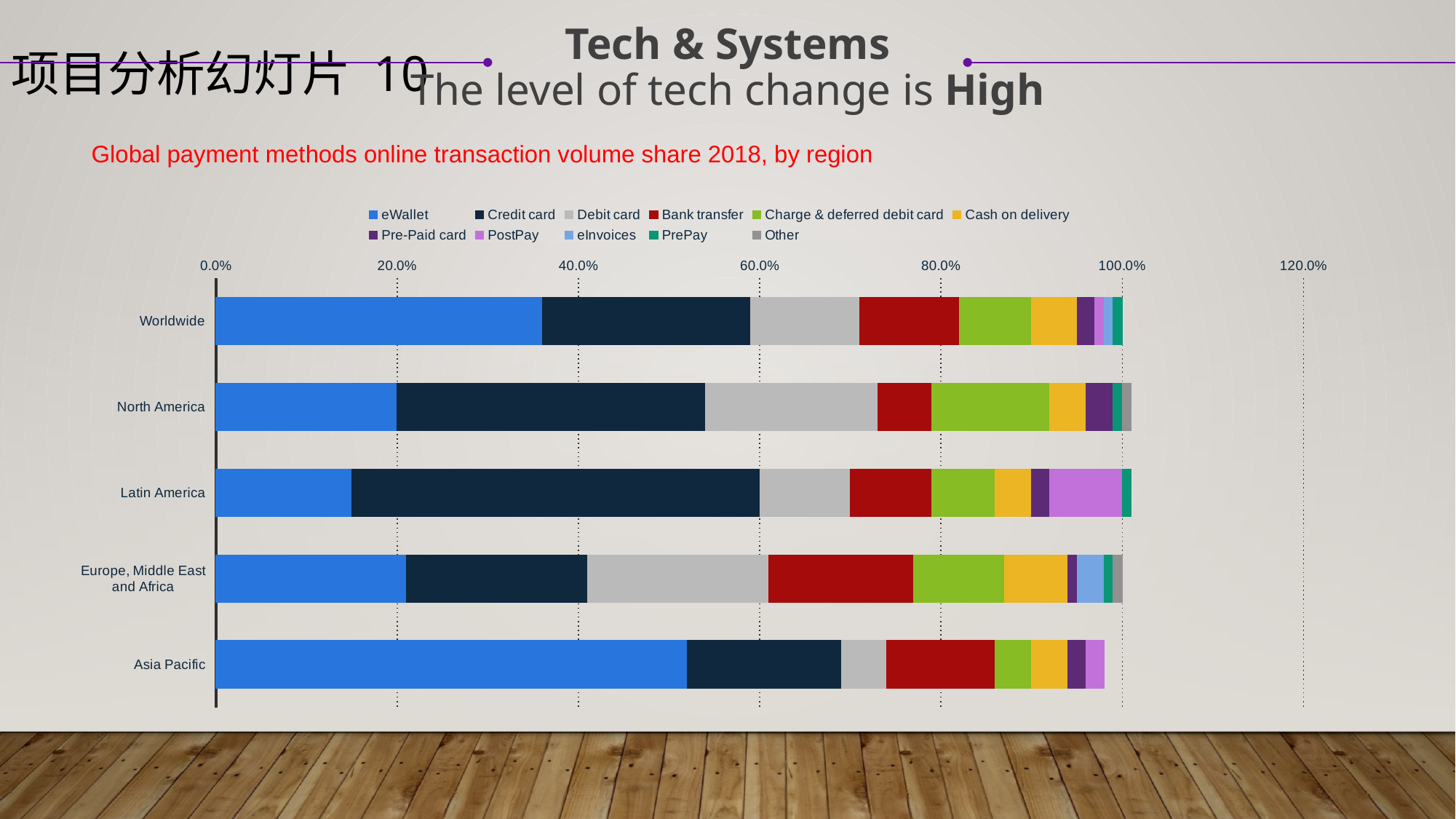
How many regions (categories) are plotted on the chart? 5 Is the eWallet share for Asia Pacific greater or less than 40.0%? greater Which region has the larger eWallet share, Asia Pacific or North America? Asia Pacific Is the eWallet share for Latin America greater or less than 20.0%? less Which region has the largest eWallet share? Asia Pacific What kind of chart is shown on the slide? Stacked bar chart Is the eWallet share for Worldwide greater or less than 40.0%? less Which region has the largest PostPay segment? Latin America How many payment-method series does the legend list? 11 What is the title of the chart? Global payment methods online transaction volume share 2018, by region Which region has the smallest eWallet share? Latin America Which region has the largest Credit card segment? Latin America